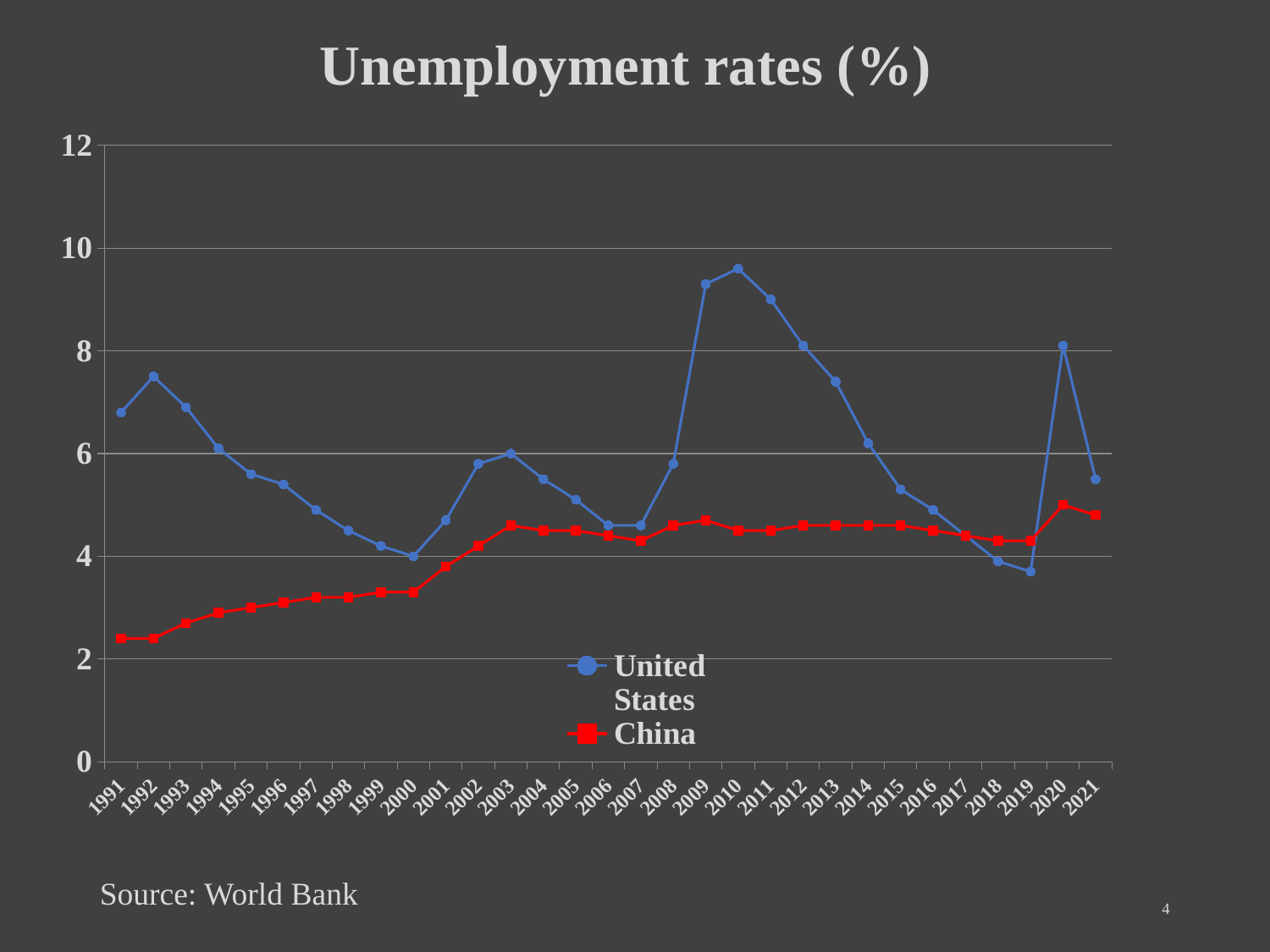
Is the United States value for 2020 greater or less than 6? greater What is the title of the chart? Unemployment rates (%) How many series does the legend list? 2 What kind of chart is shown on the slide? line chart In 2019, which series has the higher value, United States or China? China How many years are plotted along the x axis? 31 In 2010, which series has the higher value, United States or China? United States Is the United States value for 2010 greater or less than 8? greater Is the China value for 1991 greater or less than 4? less In which year does the United States series reach its highest value? 2010 Does the China series rise or fall from 1991 to 2003? rise